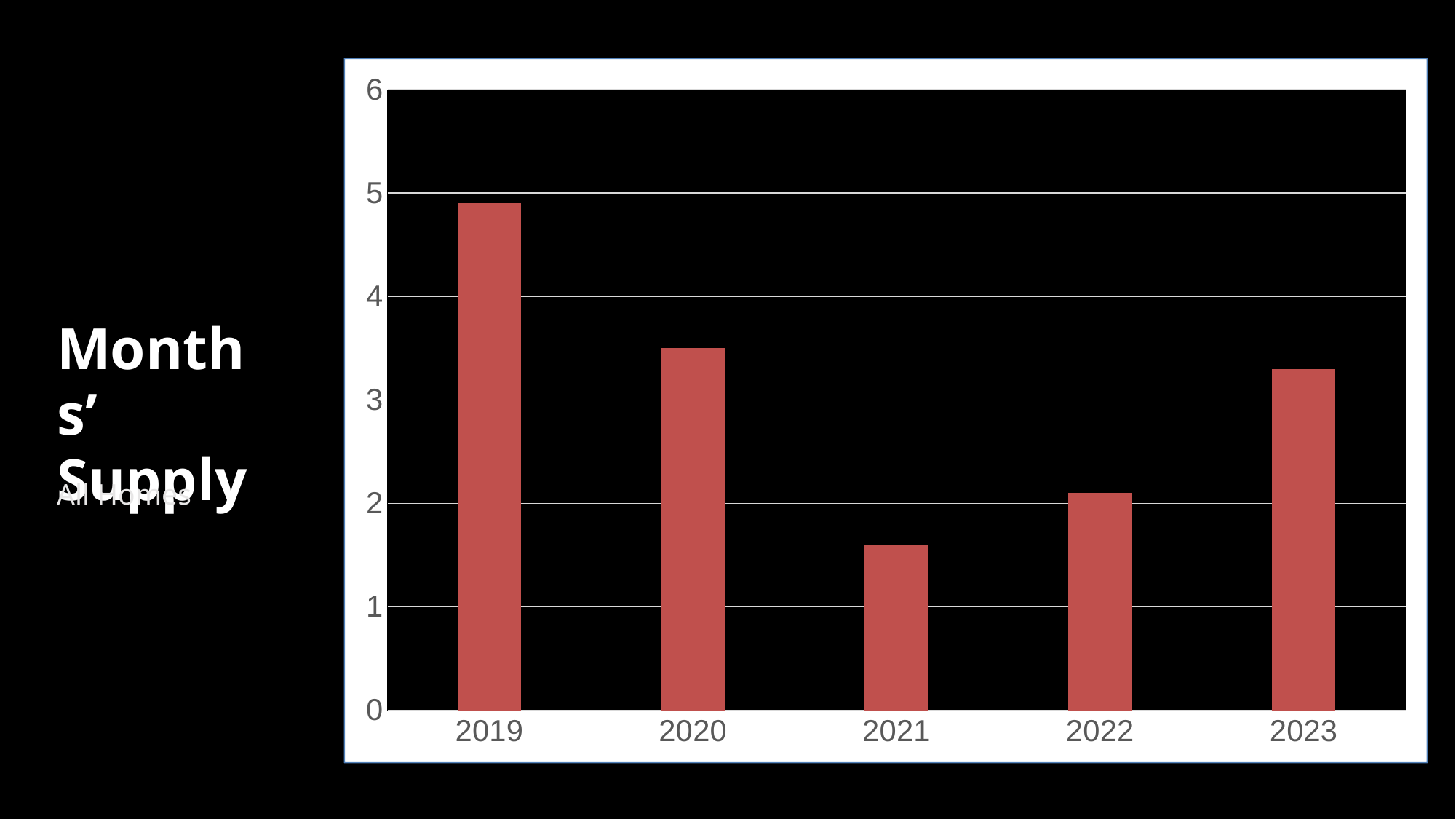
Do the values rise or fall from 2019 to 2021? fall Which year has the lowest bar in the chart? 2021 Is the value for 2021 greater or less than 2? less Which is larger, the value for 2020 or the value for 2023? 2020 Is the value for 2020 greater or less than 4? less Which year has the highest bar in the chart? 2019 Is the value for 2019 greater or less than 4? greater How many years are shown on the x axis of the chart? 5 What is the maximum value shown on the y axis of the chart? 6 What kind of chart is shown on the slide? bar chart Which is larger, the value for 2022 or the value for 2021? 2022